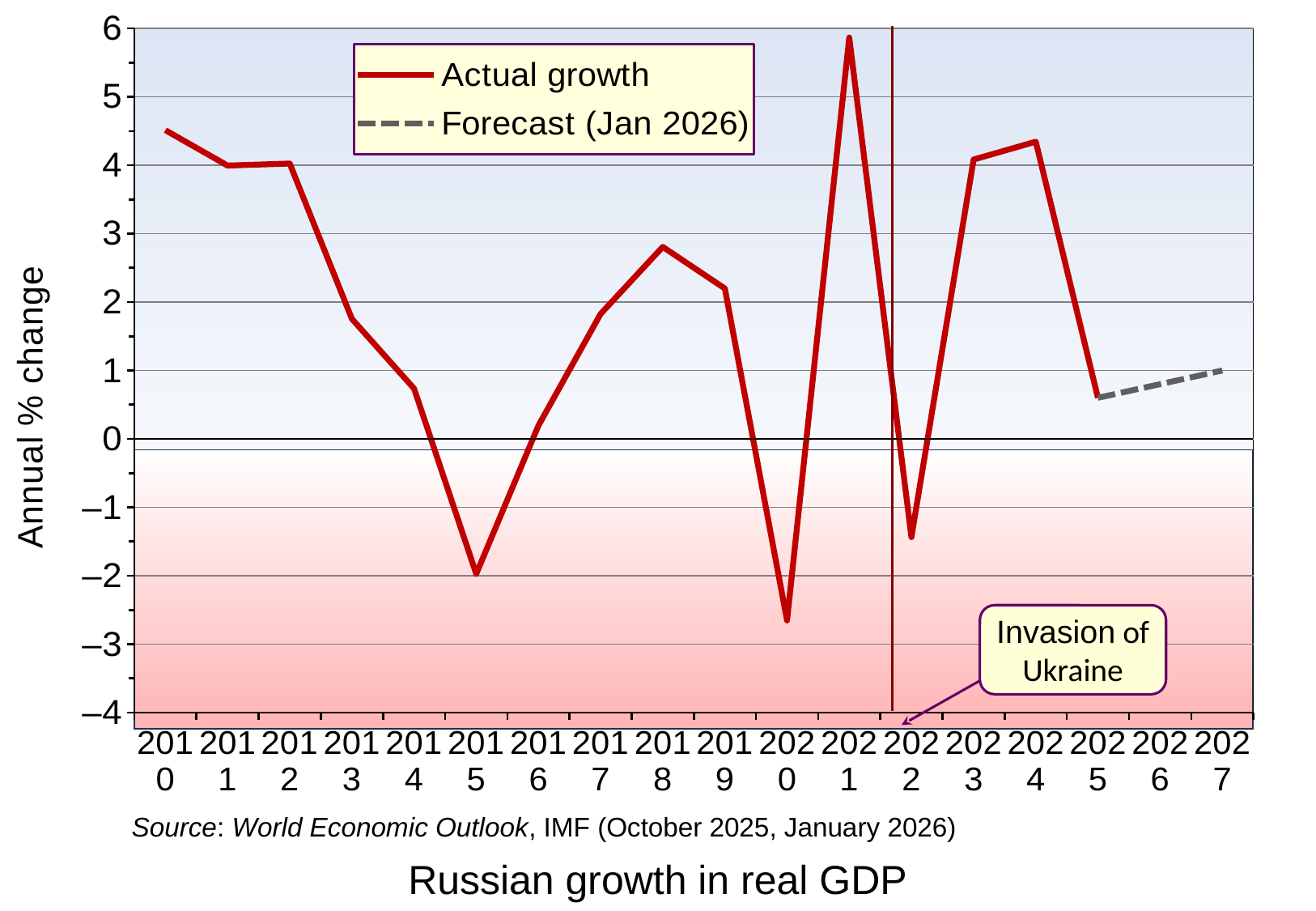
How many years are shown along the x axis? 18 Which year has the higher growth value, 2010 or 2019? 2010 Is the value for 2015 greater or less than -1? less In which year is Russian real GDP growth highest? 2021 Do the actual growth values rise or fall from 2010 to 2015? fall Is the value for 2021 greater or less than 5? greater What event does the annotation on the chart mark? Invasion of Ukraine What kind of chart is shown on the slide? line chart In which year is Russian real GDP growth lowest? 2020 How many series does the legend list? 2 Is the value for 2020 greater or less than -2? less